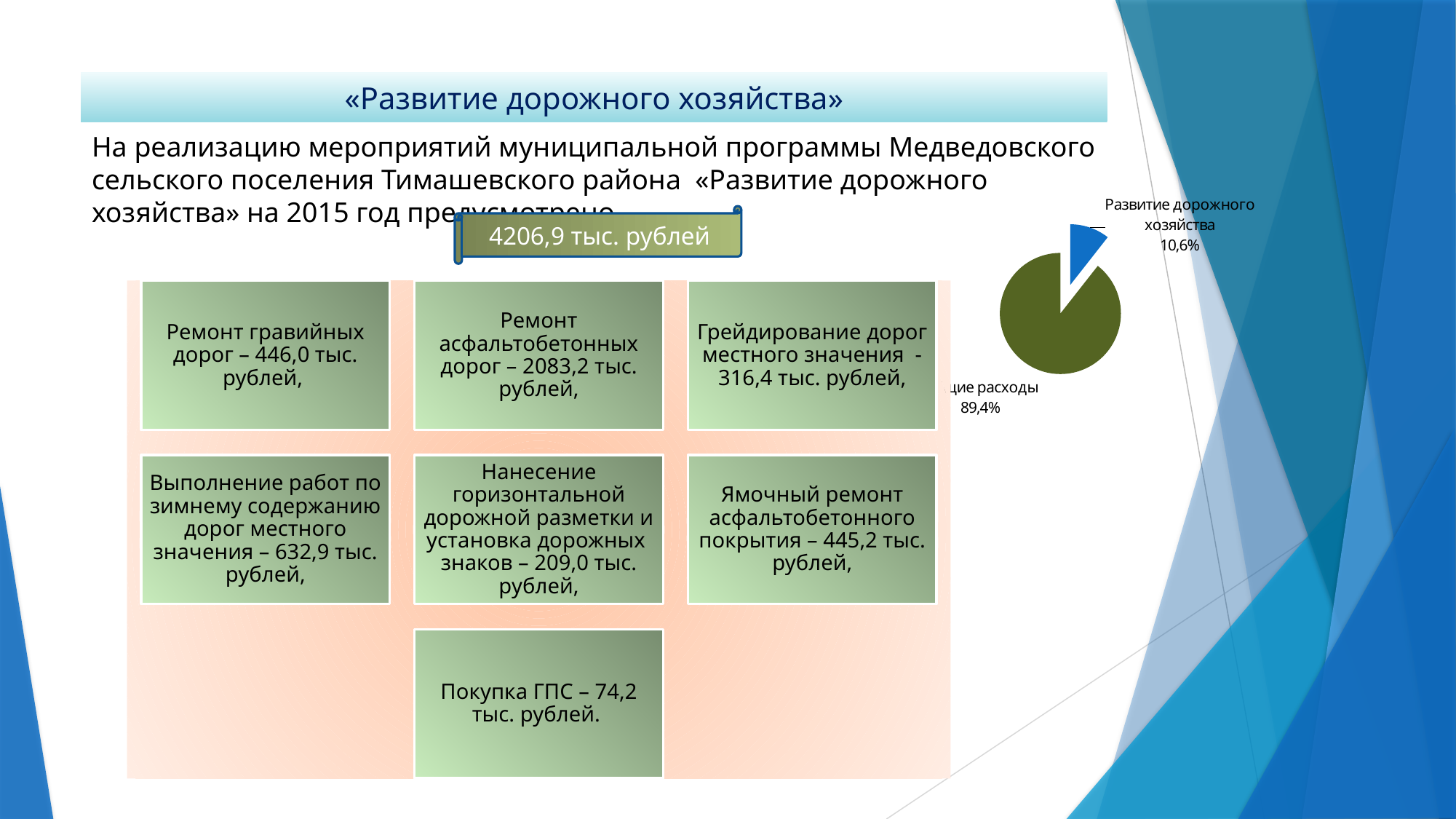
Is the share for "Развитие дорожного хозяйства" greater or less than 50%? less What colour is the slice labelled 89,4% in the pie chart? dark olive green What percentage is shown on the larger slice of the pie chart? 89,4% What share of the pie chart is labelled "Развитие дорожного хозяйства"? 10,6% What colour is the "Развитие дорожного хозяйства" slice in the pie chart? blue What kind of chart is shown on the right side of the slide? pie chart Is the slice for "Развитие дорожного хозяйства" larger or smaller than the other slice in the pie chart? smaller How many slices does the pie chart have? 2 Which slice of the pie chart is the smallest? Развитие дорожного хозяйства What is the difference in percentage points between the two slices of the pie chart? 78,8%